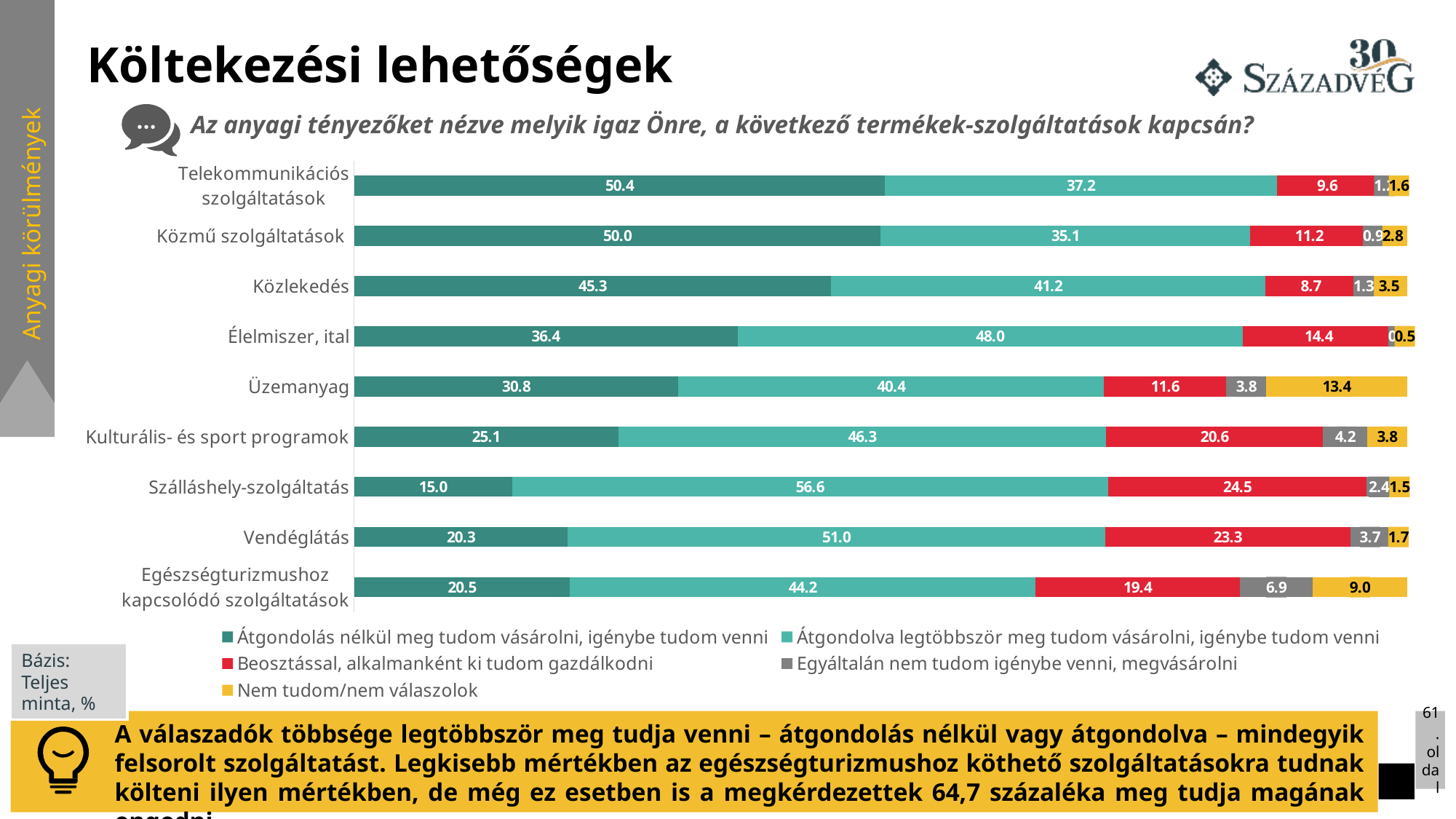
What kind of chart is shown on the slide? bar chart For Élelmiszer, ital, what is the difference between the 'Átgondolva legtöbbször' value and the 'Átgondolás nélkül' value? 11.6 Which has the larger 'Átgondolva legtöbbször meg tudom vásárolni' value: Közlekedés or Üzemanyag? Közlekedés How many product/service categories are plotted in the chart? 9 How many series does the legend list? 5 Which category has the lowest value for 'Átgondolás nélkül meg tudom vásárolni, igénybe tudom venni'? Szálláshely-szolgáltatás What is the 'Egyáltalán nem tudom igénybe venni, megvásárolni' value for Egészségturizmushoz kapcsolódó szolgáltatások? 6.9 What is the total of the stacked bar for Üzemanyag? 100.0 What is the 'Nem tudom/nem válaszolok' value for Üzemanyag? 13.4 What is the value of 'Átgondolva legtöbbször meg tudom vásárolni, igénybe tudom venni' for Szálláshely-szolgáltatás? 56.6 Which category has the highest value for 'Beosztással, alkalmanként ki tudom gazdálkodni'? Szálláshely-szolgáltatás What colour represents 'Nem tudom/nem válaszolok' in the legend? yellow